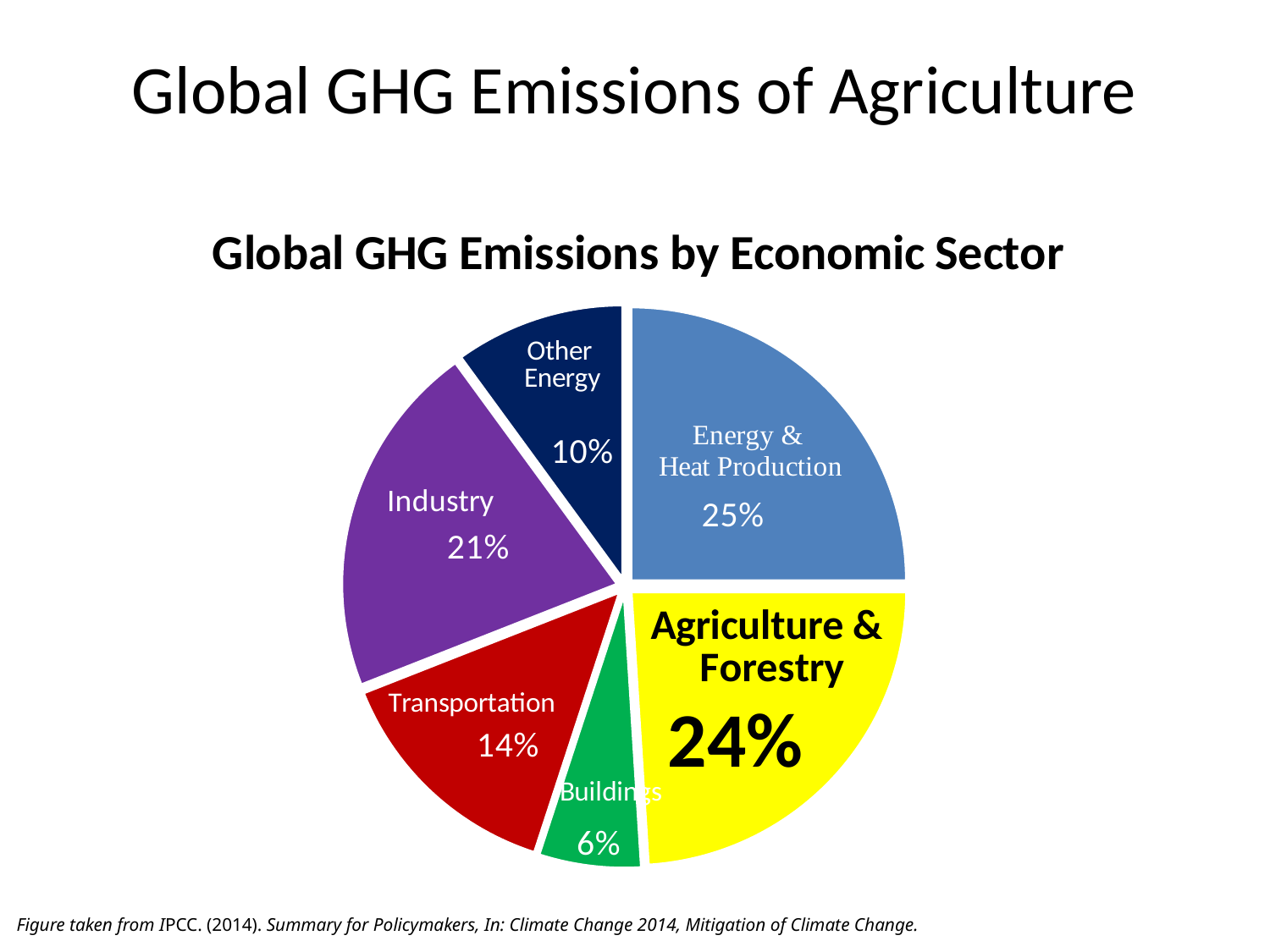
What type of chart is shown on the slide? pie chart How many sectors are shown in the pie chart? 6 What is the difference in percentage points between Industry and Other Energy? 11 Which is larger, the share for Transportation or the share for Industry? Industry What is the title of the chart? Global GHG Emissions by Economic Sector What percentage is shown for Transportation? 14% Which sector has the largest share of the pie? Energy & Heat Production What percentage is shown for Energy & Heat Production? 25% Which sector has the smallest share of the pie? Buildings What share of global GHG emissions does Agriculture & Forestry account for? 24% What colour is the Agriculture & Forestry slice? yellow What percentage is shown for Buildings? 6%